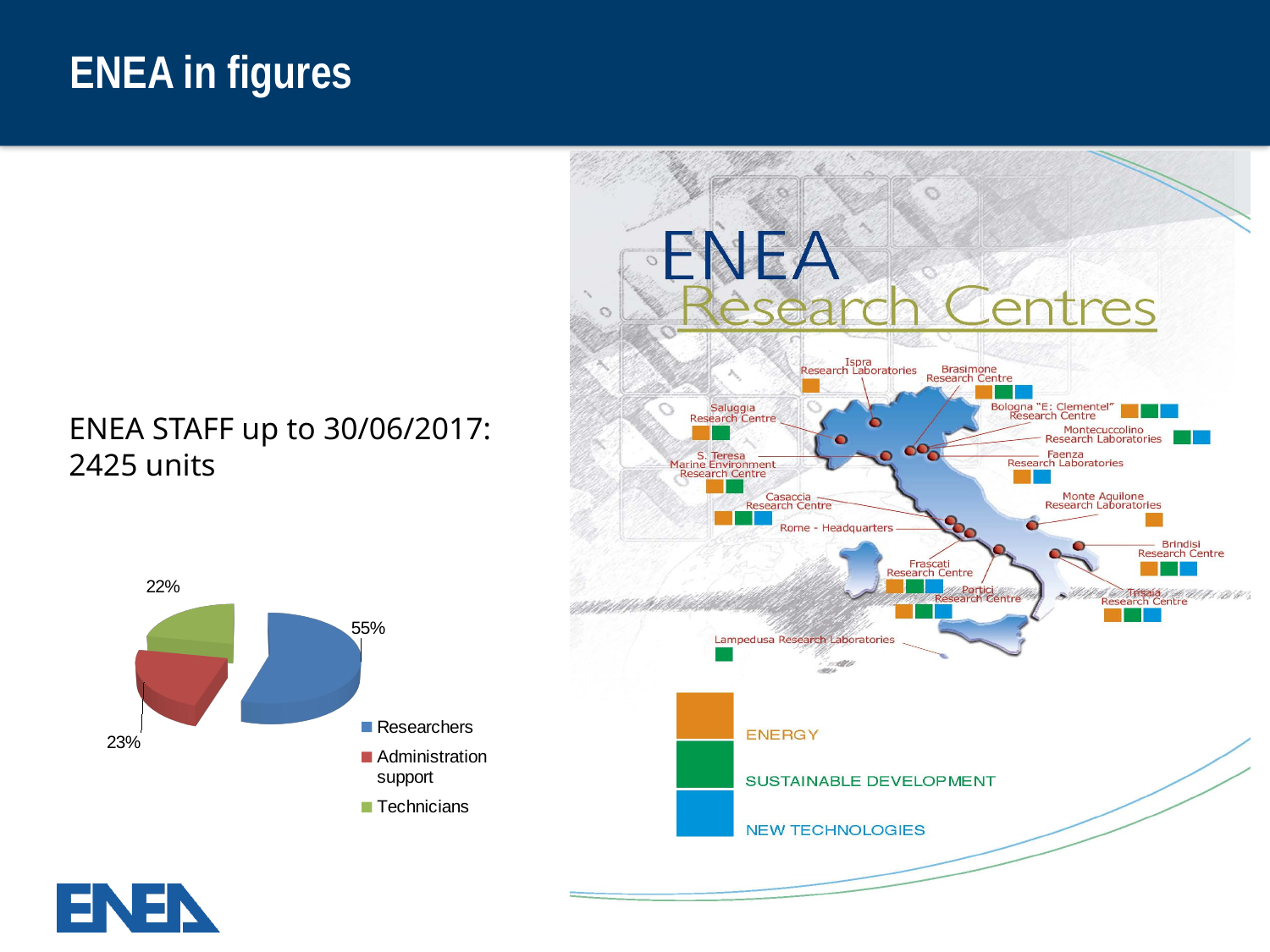
How many categories does the pie chart show? 3 Which category has the largest slice in the pie chart? Researchers How many staff units does the slide state ENEA had up to 30/06/2017? 2425 units Which category has the smallest slice in the pie chart? Technicians What share of ENEA staff are Researchers according to the pie chart? 55% What percentage of the pie chart is Technicians? 22% What is the difference in percentage points between Administration support and Technicians in the pie chart? 1 What percentage of the pie chart is Administration support? 23% What type of chart is used to show the ENEA staff breakdown? Pie chart What colour is the Researchers slice in the pie chart? Blue Which is larger in the pie chart, Researchers or Technicians? Researchers What is the difference in percentage points between Researchers and Administration support in the pie chart? 32